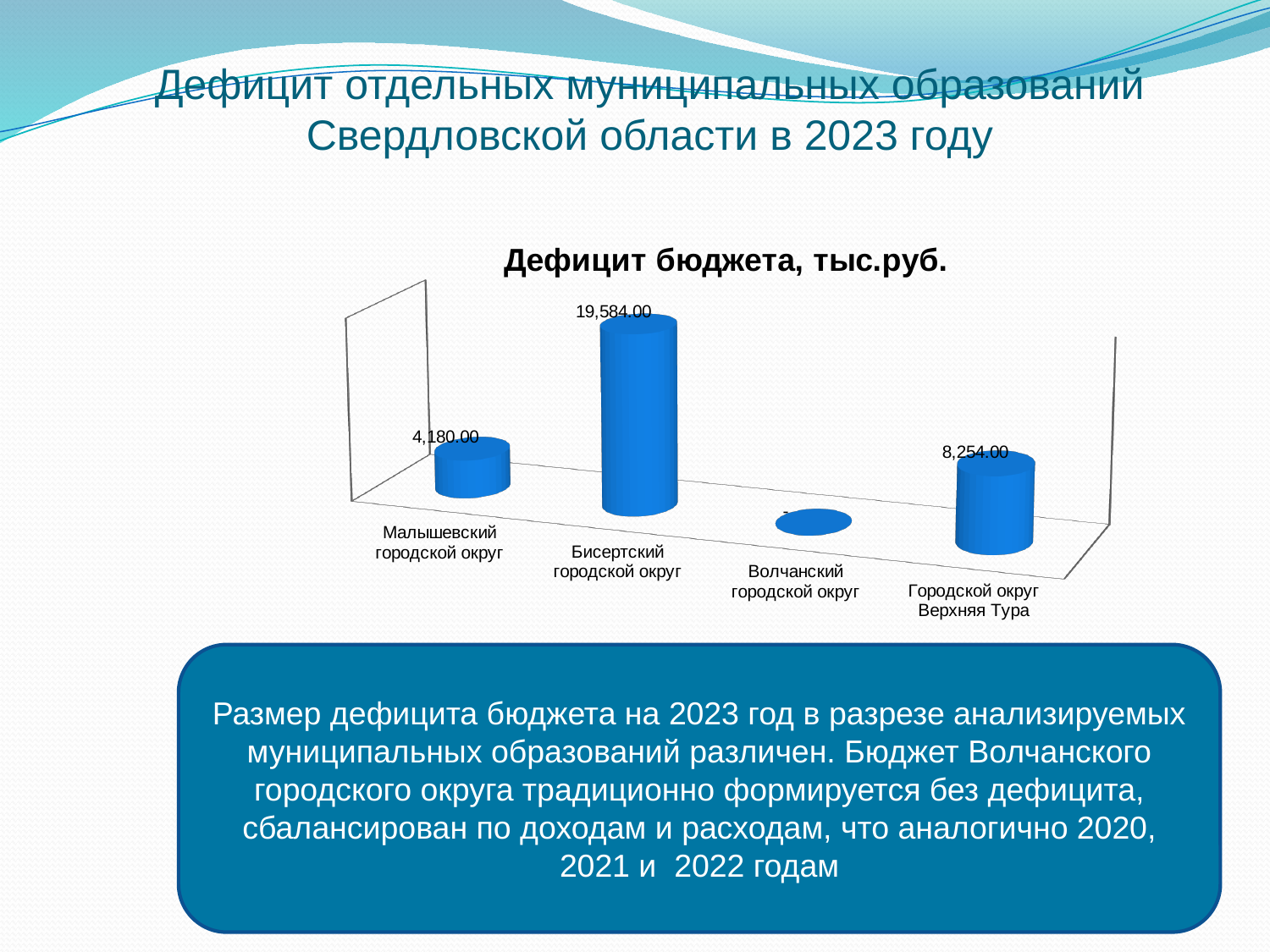
Which has a larger budget deficit, Малышевский городской округ or Городской округ Верхняя Тура? Городской округ Верхняя Тура What is the budget deficit value for Бисертский городской округ? 19,584.00 What is the budget deficit value for Городской округ Верхняя Тура? 8,254.00 What is the title of the chart? Дефицит бюджета, тыс.руб. What is the difference between the deficit of Бисертский городской округ and Городской округ Верхняя Тура? 11,330.00 What is the difference between the deficit of Городской округ Верхняя Тура and Малышевский городской округ? 4,074.00 Which municipality has the lowest budget deficit on the chart? Волчанский городской округ What is the difference between the deficit of Бисертский городской округ and Малышевский городской округ? 15,404.00 How many municipalities are shown on the chart? 4 Which municipality has the highest budget deficit on the chart? Бисертский городской округ What is the budget deficit value for Малышевский городской округ? 4,180.00 What type of chart is shown on the slide? Bar chart